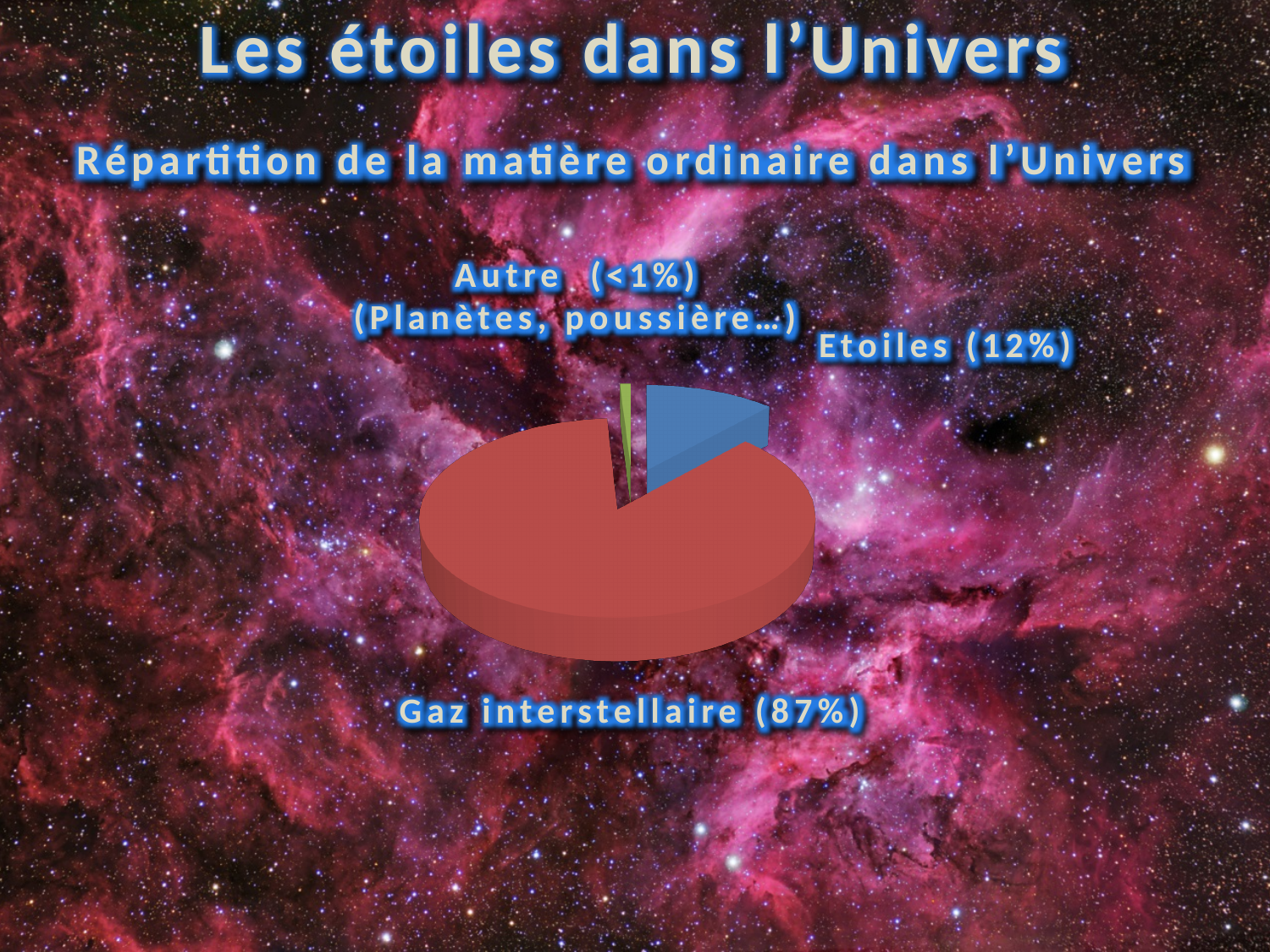
Which slice of the pie chart is the smallest? Autre (Planètes, poussière…) What share of ordinary matter does the slice "Etoiles" represent? 12% How many slices does the pie chart have? 3 Which slice of the pie chart is the largest? Gaz interstellaire By how many percentage points does the share of Gaz interstellaire exceed the share of Etoiles? 75 What share is given for the slice "Autre (Planètes, poussière…)"? <1% What kind of chart is shown on the slide? pie chart What share of ordinary matter does the slice "Gaz interstellaire" represent? 87% Which is larger, the share for Etoiles or the share for Gaz interstellaire? Gaz interstellaire What colour is the slice for Etoiles? blue What is the title of the chart on the slide? Répartition de la matière ordinaire dans l'Univers